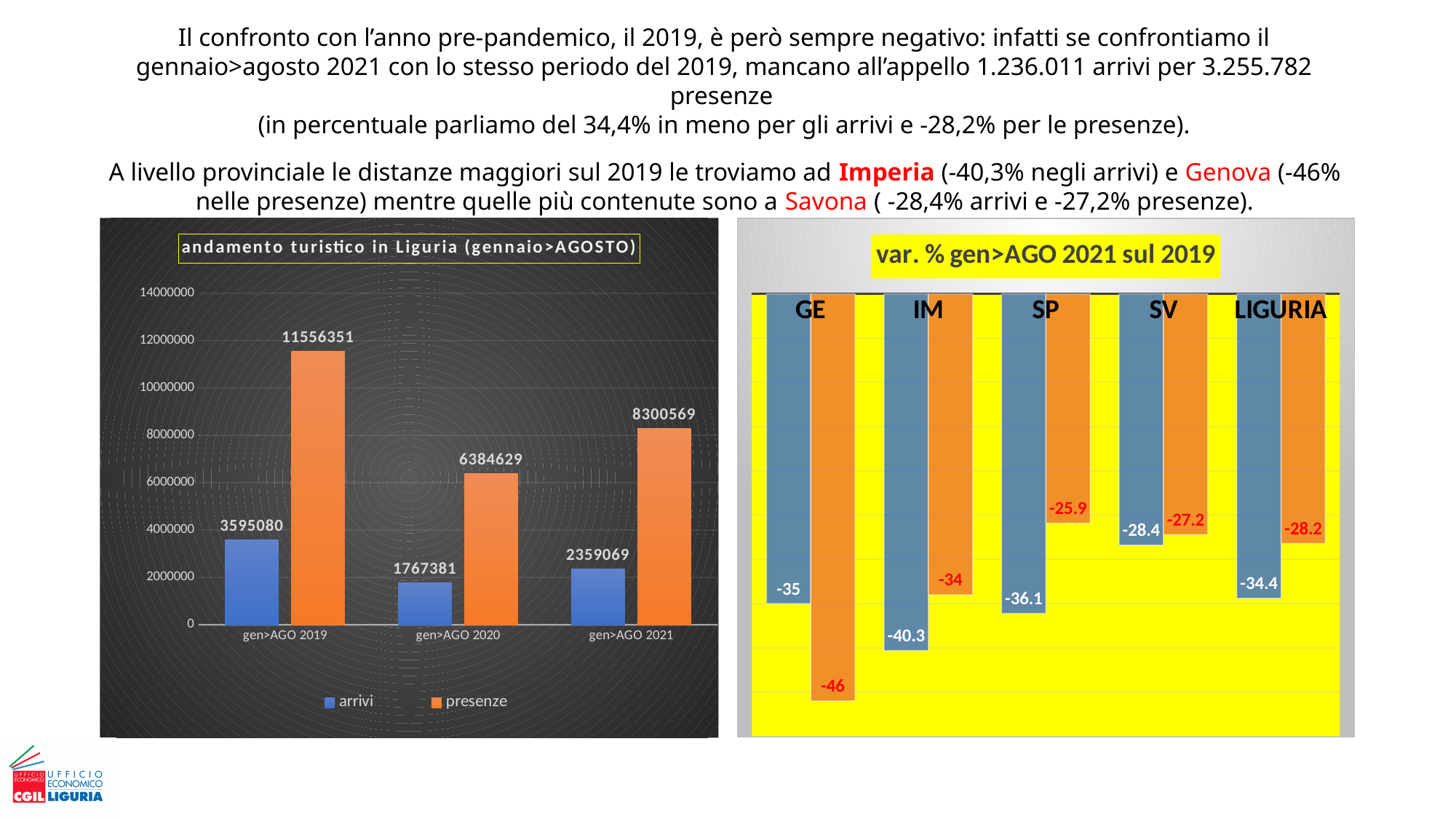
In the chart titled "andamento turistico in Liguria (gennaio>AGOSTO)", is the value of presenze for gen>AGO 2021 greater or less than 8000000? greater In the chart titled "andamento turistico in Liguria (gennaio>AGOSTO)", how many series does the legend list? 2 In the chart titled "var. % gen>AGO 2021 sul 2019", which is larger, the blue bar value for SV or the blue bar value for SP? SV In the chart titled "andamento turistico in Liguria (gennaio>AGOSTO)", what is the value of presenze for gen>AGO 2019? 11556351 What kind of chart is the chart titled "var. % gen>AGO 2021 sul 2019"? bar chart In the chart titled "var. % gen>AGO 2021 sul 2019", how many categories are shown on the x axis? 5 In the chart titled "andamento turistico in Liguria (gennaio>AGOSTO)", which period has the lowest value of presenze? gen>AGO 2020 In the chart titled "var. % gen>AGO 2021 sul 2019", what is the value of the blue bar for IM? -40.3 In the chart titled "andamento turistico in Liguria (gennaio>AGOSTO)", what is the difference between arrivi in gen>AGO 2019 and arrivi in gen>AGO 2021? 1236011 In the chart titled "var. % gen>AGO 2021 sul 2019", what is the value of the orange bar for GE? -46 In the chart titled "var. % gen>AGO 2021 sul 2019", which category has the lowest value for the orange bars? GE In the chart titled "andamento turistico in Liguria (gennaio>AGOSTO)", what is the value of arrivi for gen>AGO 2020? 1767381